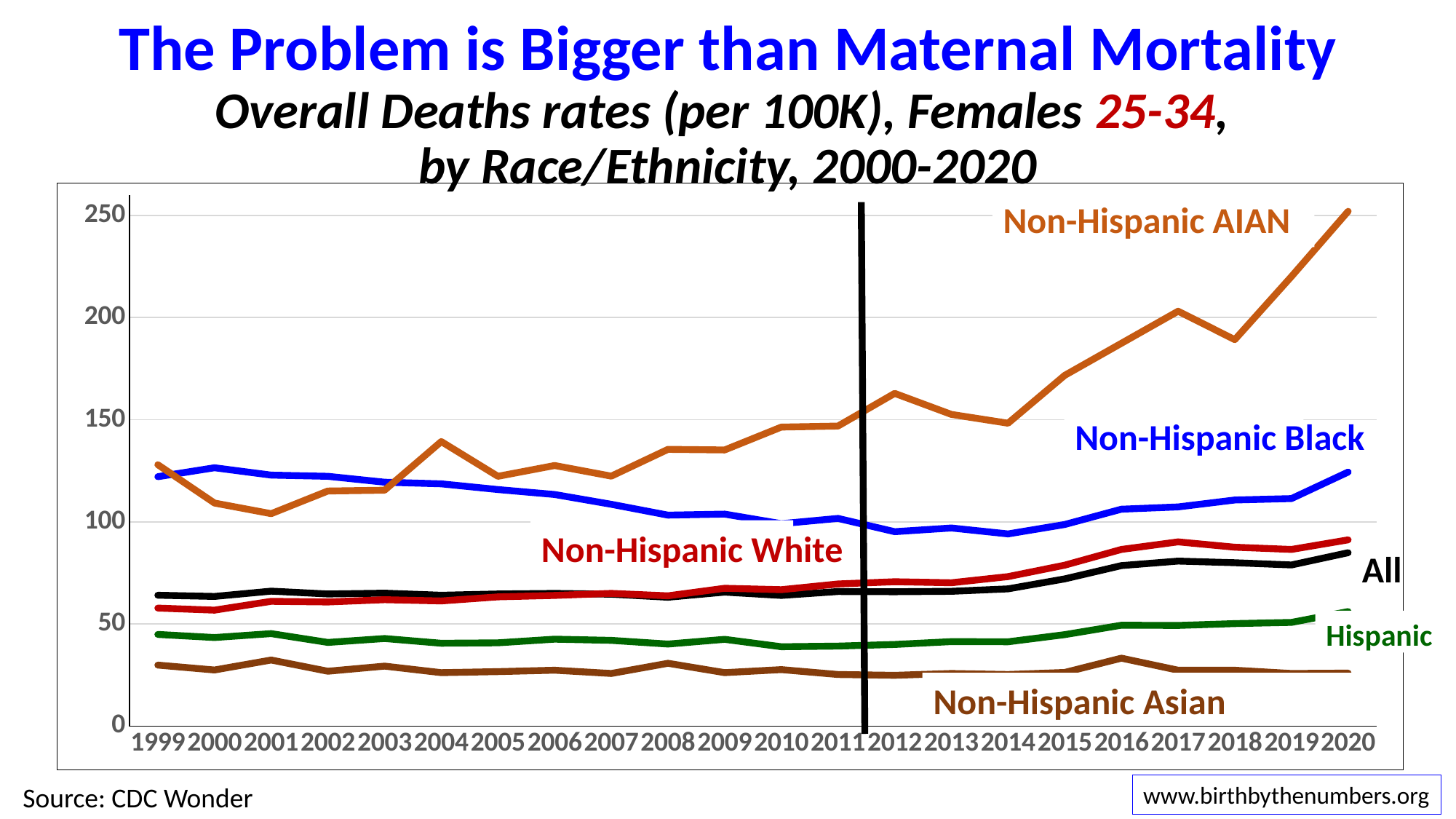
Is the value for Hispanic in 2010 greater or less than 50? less Is the value for Non-Hispanic AIAN in 2020 greater or less than 200? greater Which group has the highest death rate in 2020? Non-Hispanic AIAN What kind of chart is shown on the slide? line chart Does the Non-Hispanic AIAN line rise or fall from 2014 to 2020? rise Which group has the lowest death rate in 2020? Non-Hispanic Asian Is the value for All in 2020 greater or less than 100? less How many series are labelled on the chart? 6 Does the Non-Hispanic Black line rise or fall from 2000 to 2014? fall In 2020, which is higher: Non-Hispanic Black or Non-Hispanic White? Non-Hispanic Black How many years are shown along the x axis of the chart? 22